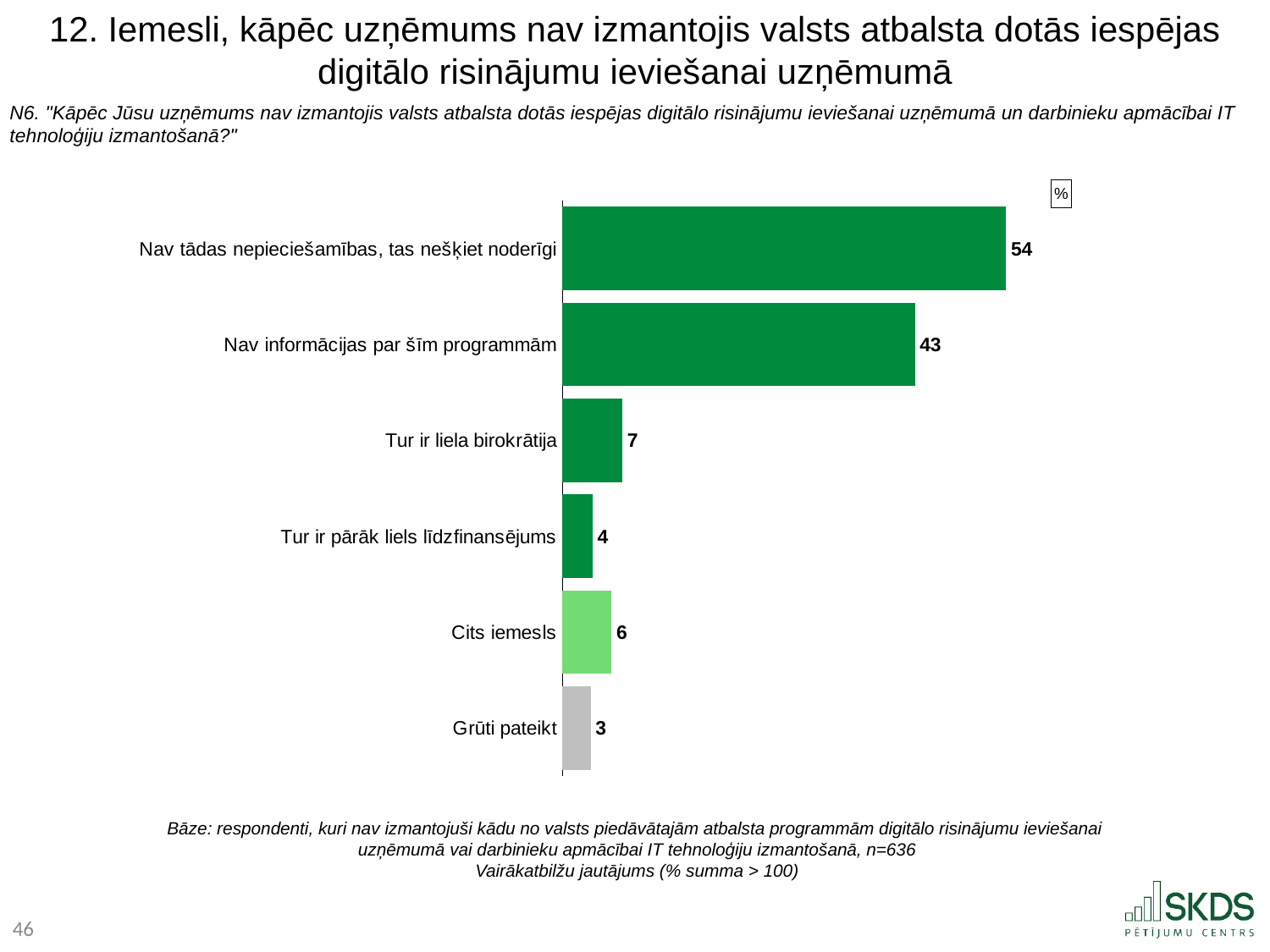
How many categories are shown in the chart? 6 Which category has the lowest value? Grūti pateikt What is the value for "Nav informācijas par šīm programmām"? 43 What is the value for "Tur ir pārāk liels līdzfinansējums"? 4 What kind of chart is shown on the slide? Bar chart Which category has the highest value? Nav tādas nepieciešamības, tas nešķiet noderīgi What is the difference between the values for "Nav tādas nepieciešamības, tas nešķiet noderīgi" and "Nav informācijas par šīm programmām"? 11 What is the value for "Tur ir liela birokrātija"? 7 What is the value for "Nav tādas nepieciešamības, tas nešķiet noderīgi"? 54 What is the sample size (n) stated in the base note below the chart? n=636 What is the value for "Grūti pateikt"? 3 Which is larger: the value for "Cits iemesls" or the value for "Tur ir pārāk liels līdzfinansējums"? Cits iemesls